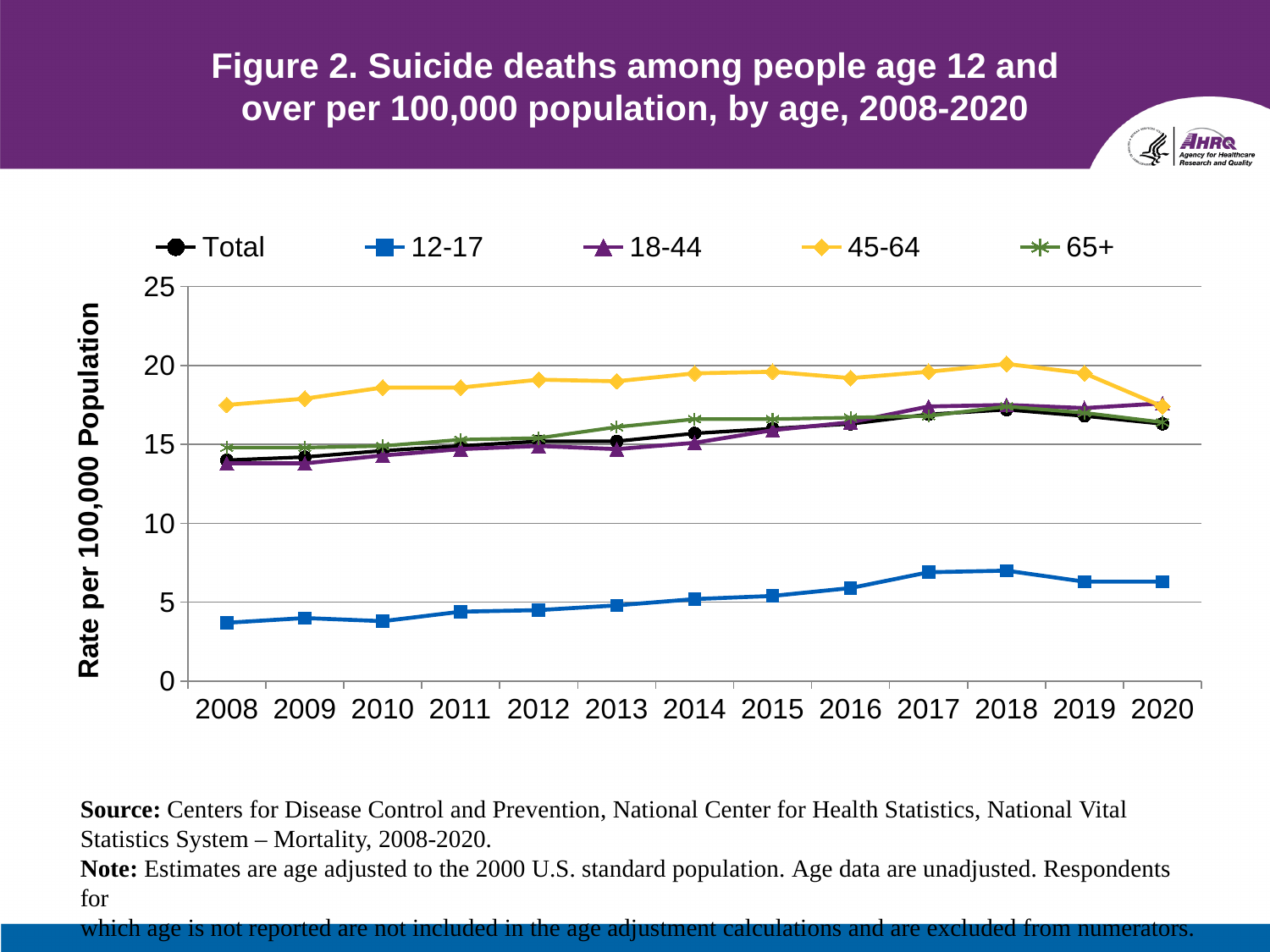
What kind of chart is shown on the slide? line chart Is the value for the 12-17 age group in 2018 greater or less than 5? greater Is the value for the 45-64 age group in 2008 greater or less than 15? greater What is the title of the y axis? Rate per 100,000 Population How many years are plotted along the x axis? 13 Which age group has the lowest suicide death rate across all years shown? 12-17 Is the value for the Total series in 2008 greater or less than 15? less Which is larger in 2015, the value for 45-64 or the value for 12-17? 45-64 How many series does the legend list? 5 Does the 12-17 series rise or fall from 2008 to 2018? rise